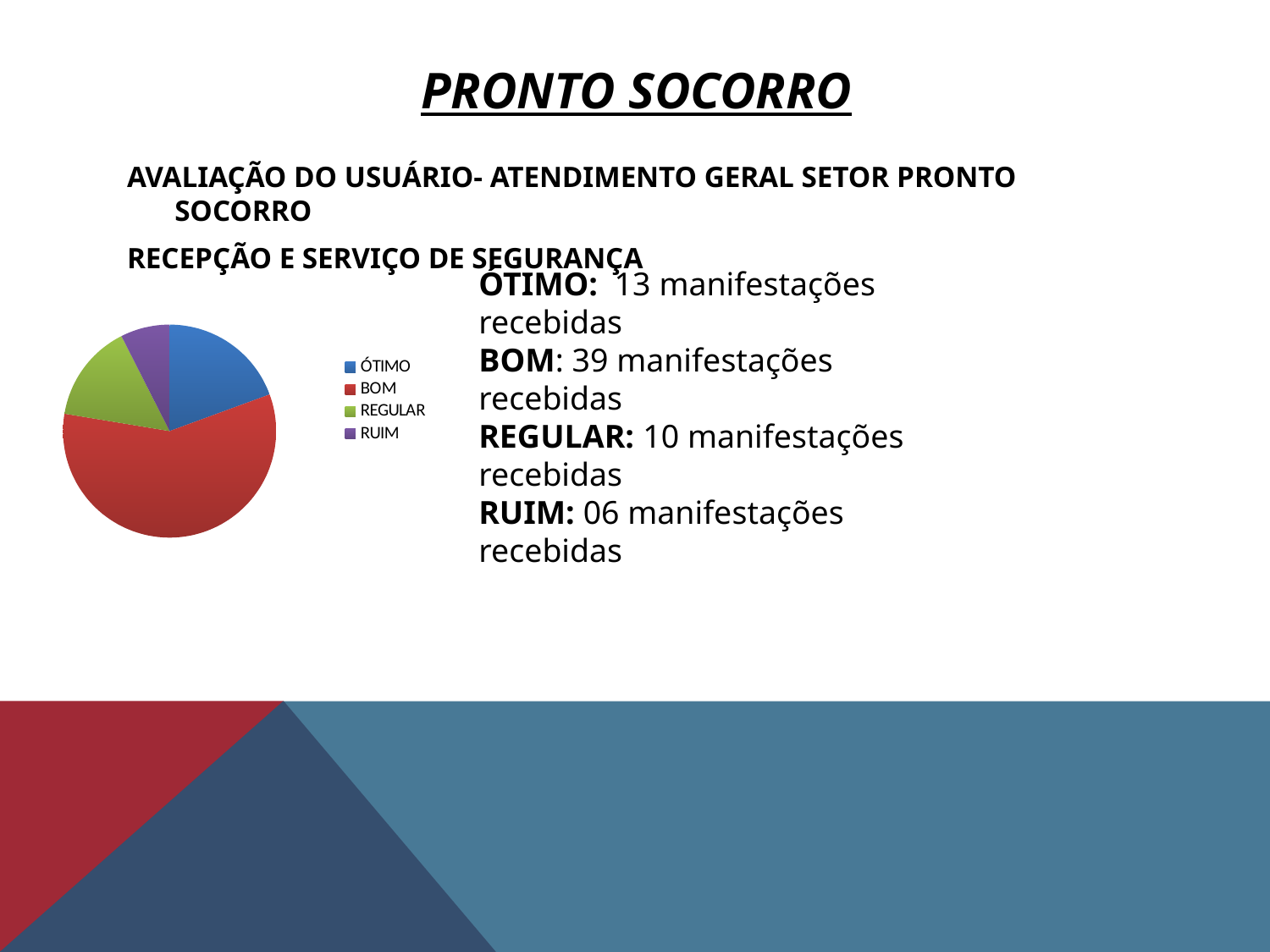
How many manifestações recebidas are reported for ÓTIMO? 13 How many manifestações recebidas are reported for BOM? 39 How many manifestações recebidas are reported for RUIM? 06 What kind of chart is shown on the slide? pie chart How many categories does the pie chart have? 4 Which slice is larger in the pie chart, BOM or REGULAR? BOM What colour is the BOM slice in the pie chart? red What is the difference between the number of manifestações for BOM and for ÓTIMO? 26 How many manifestações recebidas are reported for REGULAR? 10 Which category has the smallest slice of the pie chart? RUIM Which category has the largest slice of the pie chart? BOM How many entries does the legend of the pie chart list? 4